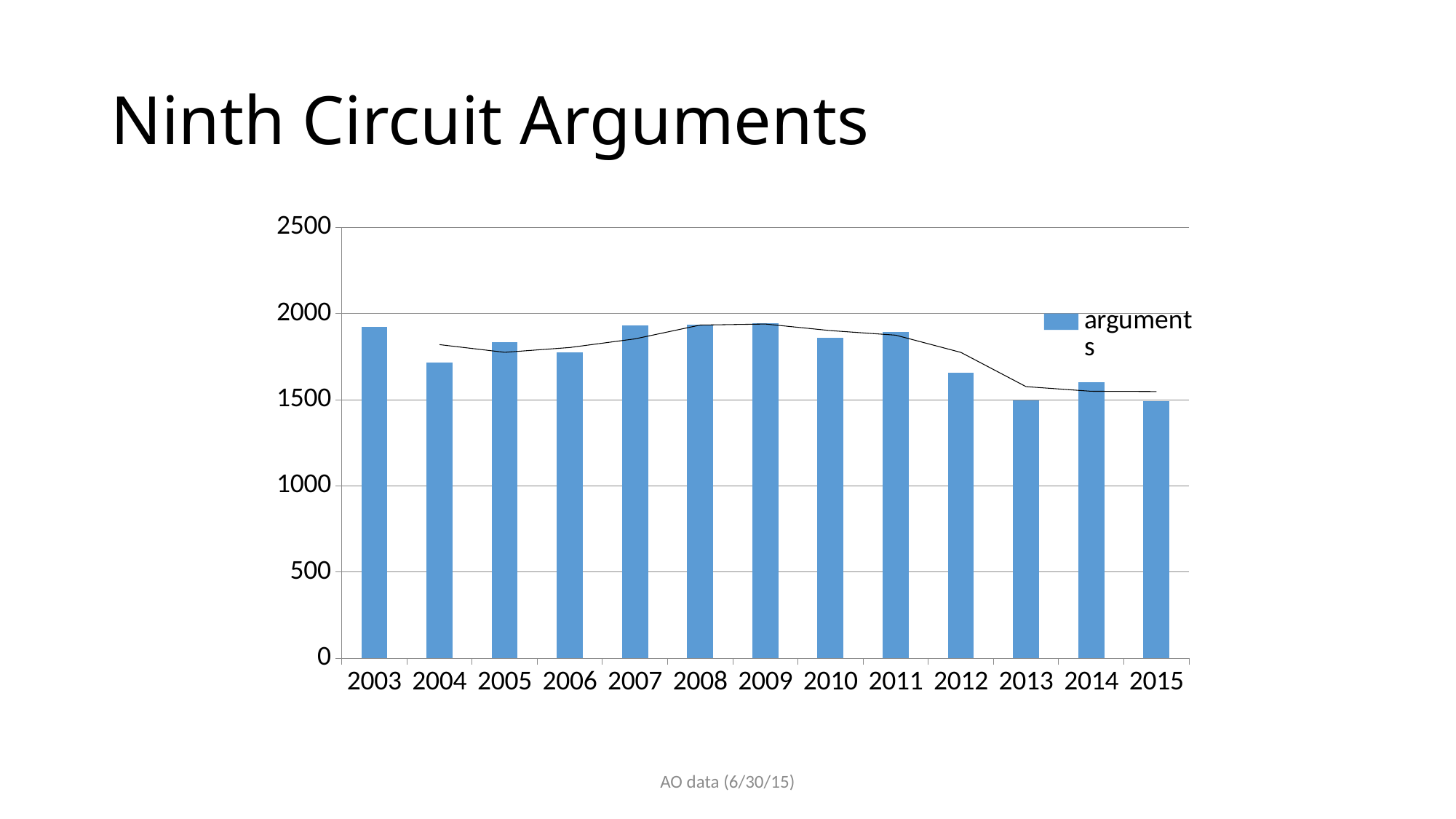
What is the title of the slide containing the chart? Ninth Circuit Arguments Is the value for 2003 greater or less than 1500? greater Which year has the larger value, 2003 or 2004? 2003 What kind of chart is shown on the slide? bar chart What is the name of the series shown in the legend? arguments How many series does the chart's legend list? 1 Is the value for 2012 greater or less than 1500? greater How many years are plotted on the x axis of the chart? 13 Is the value for 2015 greater or less than 2000? less Do the values generally rise or fall from 2011 to 2015? fall Which year has the larger value, 2012 or 2013? 2012 Which year has the larger value, 2006 or 2007? 2007